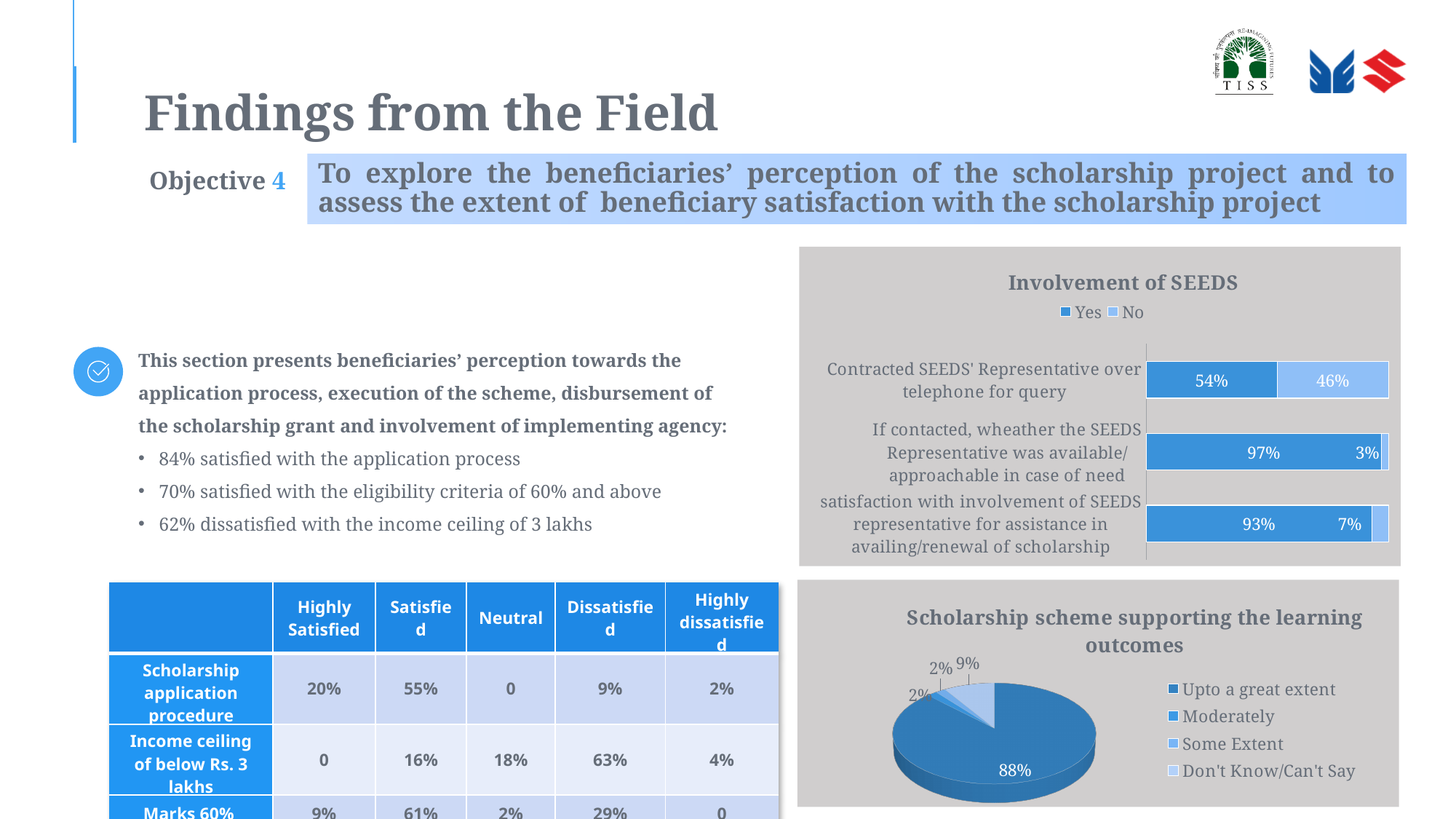
In the 'Involvement of SEEDS' chart, what percentage answered Yes to 'Contracted SEEDS' Representative over telephone for query'? 54% In the 'Involvement of SEEDS' chart, which category has the lowest Yes percentage? Contracted SEEDS' Representative over telephone for query How many series does the legend of the 'Involvement of SEEDS' chart list? 2 How many categories does the legend of the 'Scholarship scheme supporting the learning outcomes' pie chart list? 4 In the 'Involvement of SEEDS' chart, what percentage said Yes to whether the SEEDS Representative was available/approachable in case of need? 97% In the 'Involvement of SEEDS' chart, which category has the highest Yes percentage? If contacted, wheather the SEEDS Representative was available/approachable in case of need In the 'Involvement of SEEDS' chart, what is the No value for satisfaction with involvement of SEEDS representative for assistance in availing/renewal of scholarship? 7% In the 'Involvement of SEEDS' chart, what is the difference between the Yes and No values for 'Contracted SEEDS' Representative over telephone for query'? 8% In the 'Scholarship scheme supporting the learning outcomes' pie chart, what share is 'Upto a great extent'? 88% What type of chart is 'Scholarship scheme supporting the learning outcomes'? Pie chart What type of chart is 'Involvement of SEEDS'? Bar chart In the 'Involvement of SEEDS' chart, what is the No value for 'Contracted SEEDS' Representative over telephone for query'? 46%